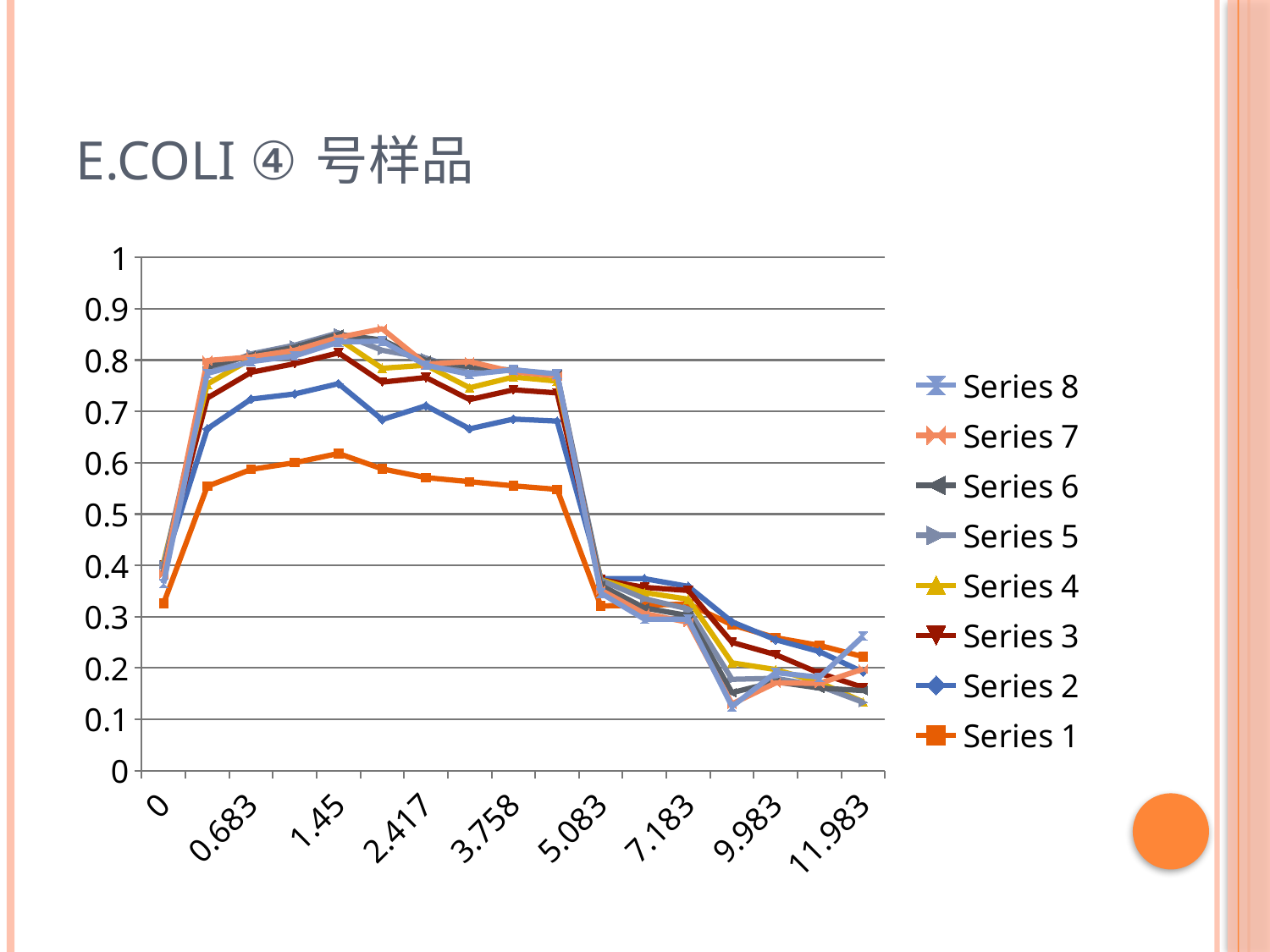
What kind of chart is shown on the slide? line chart Which series has the lowest value at x = 1.45? Series 1 Does Series 1 rise or fall between x = 5.083 and x = 11.983? fall Is the value of Series 1 at x = 1.45 greater or less than 0.5? greater Is the value of Series 1 at x = 5.083 greater or less than 0.4? less At x = 1.45, which is larger: Series 1 or Series 2? Series 2 How many x-axis labels are shown on the chart? 9 How many series does the legend list? 8 Is the value of Series 1 at x = 0 greater or less than 0.4? less What is the title of the slide containing the chart? E.COLI ④ 号样品